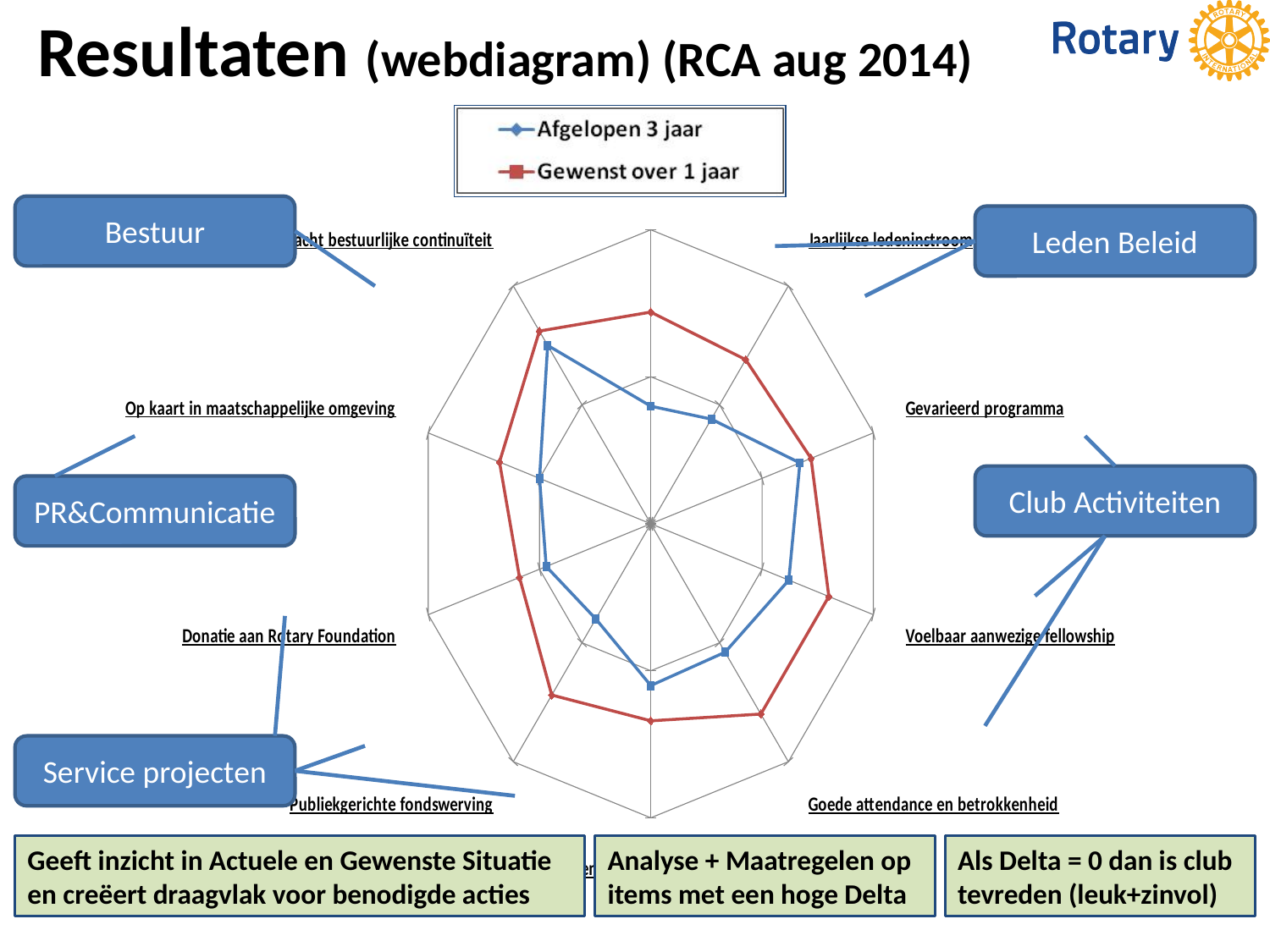
For 'Donatie aan Rotary Foundation', which series lies further from the centre of the chart? Gewenst over 1 jaar For 'Voelbaar aanwezige fellowship', which series has the higher value? Gewenst over 1 jaar How many axes (spokes) does the radar chart have? 10 What kind of chart is shown on the slide? Radar chart For 'Gevarieerd programma', which series has the higher value: Afgelopen 3 jaar or Gewenst over 1 jaar? Gewenst over 1 jaar Which colour represents the series 'Gewenst over 1 jaar' in the chart? Red What are the two series named in the chart legend? Afgelopen 3 jaar and Gewenst over 1 jaar How many series does the chart legend list? 2